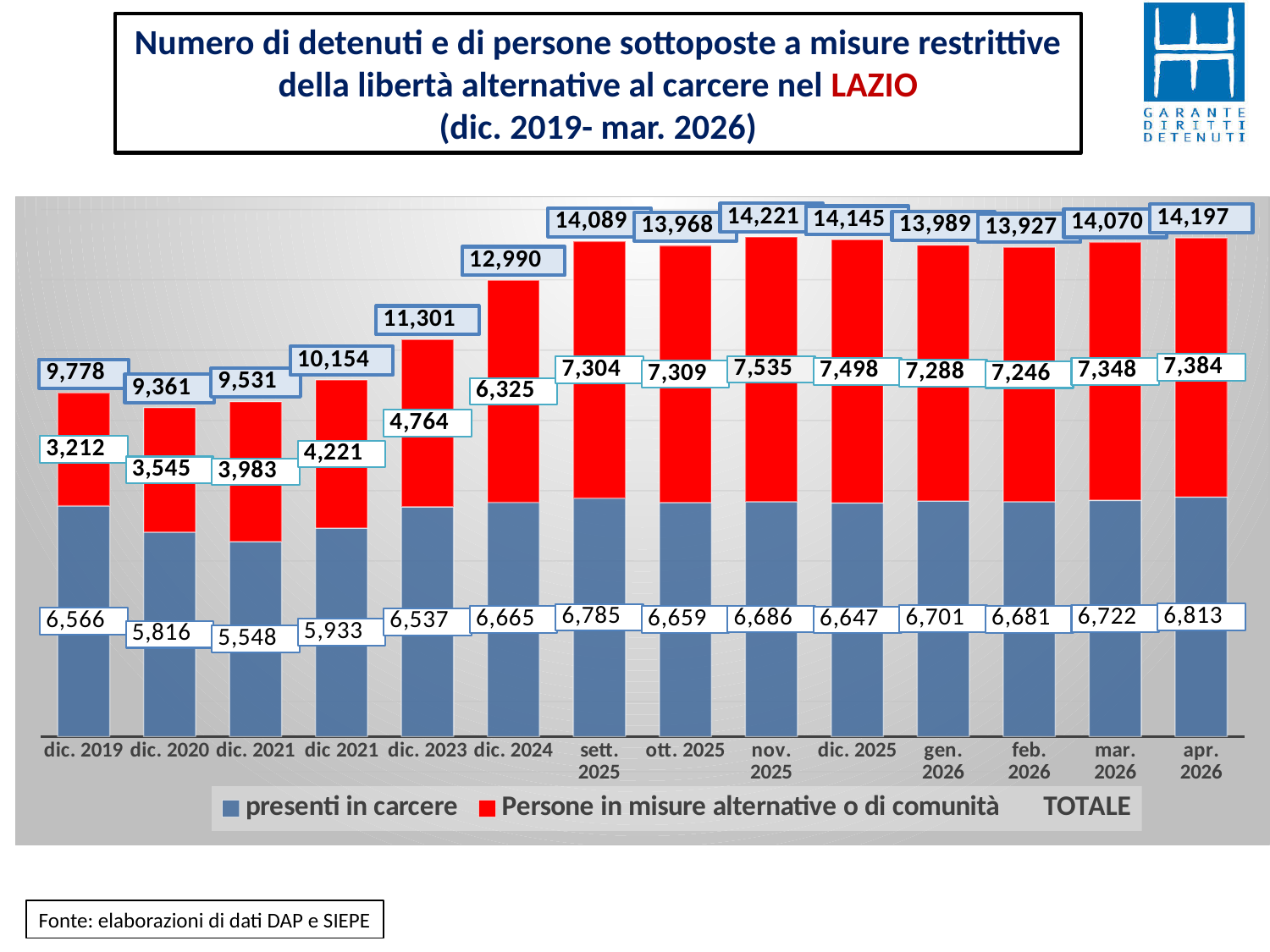
What type of chart is shown on the slide? stacked bar chart What is the value of 'presenti in carcere' for dic. 2019? 6,566 How many series does the legend list? 3 In apr. 2026, which is larger: 'presenti in carcere' or 'Persone in misure alternative o di comunità'? Persone in misure alternative o di comunità Which period has the lowest TOTALE value? dic. 2020 What is the TOTALE value for dic. 2024? 12,990 What is the value of 'Persone in misure alternative o di comunità' for apr. 2026? 7,384 How many time periods (categories) are shown on the x axis? 14 What colour represents 'Persone in misure alternative o di comunità' in the chart? red Which period has the highest TOTALE value? nov. 2025 What is the difference between the TOTALE for apr. 2026 and the TOTALE for dic. 2019? 4,419 Which period has the lowest value for 'Persone in misure alternative o di comunità'? dic. 2019